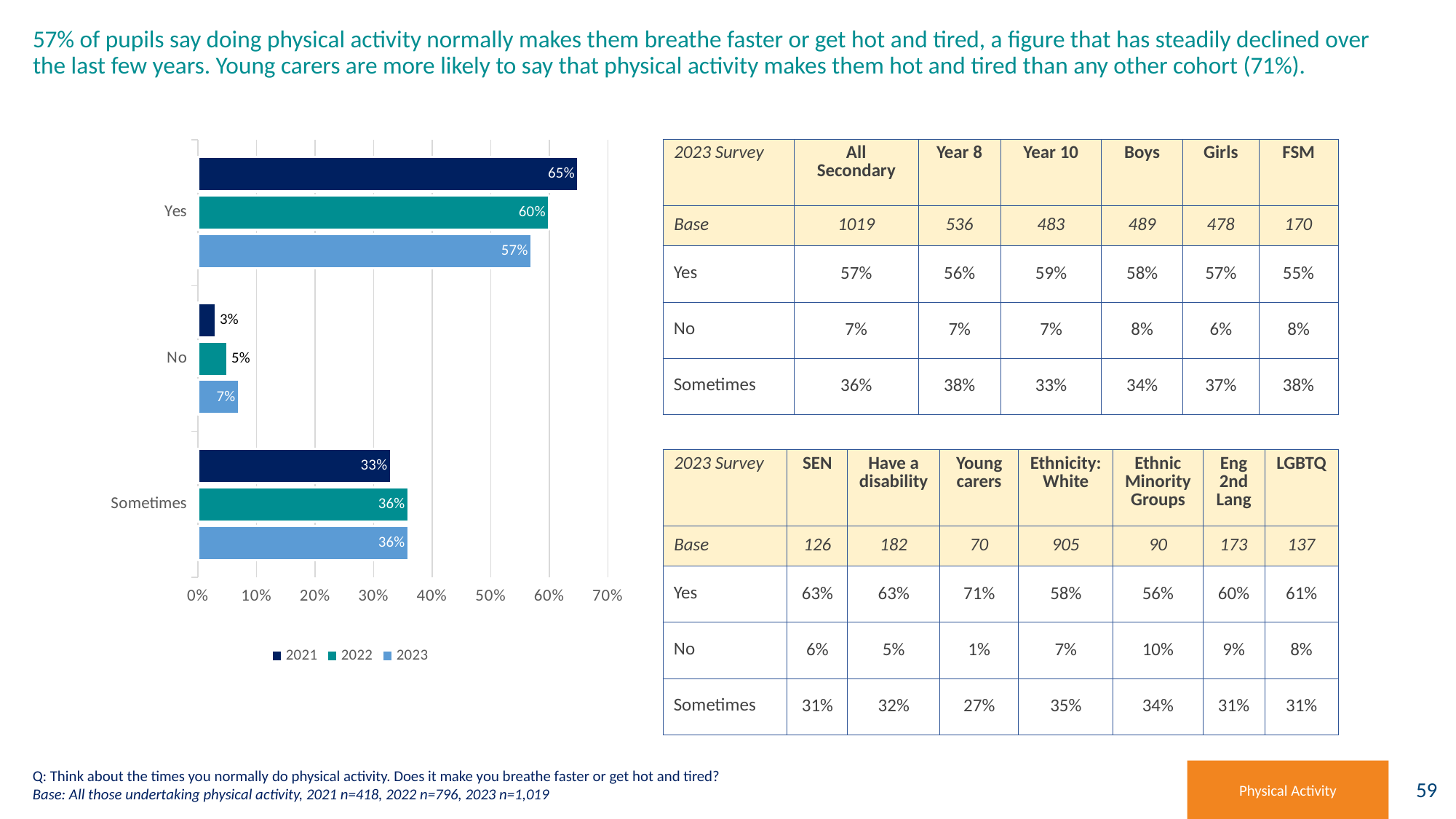
What percentage of pupils answered 'Yes' in 2023? 57% What percentage of pupils answered 'Sometimes' in 2022? 36% How many response categories are shown on the chart? 3 What is the difference between the 'Yes' percentage in 2021 and in 2023? 8 percentage points What percentage of pupils answered 'No' in 2021? 3% How many series does the chart legend list? 3 Which is larger: the 'Sometimes' value for 2021 or for 2023? 2023 Is the 'Yes' value for 2022 greater or less than 50%? greater Which year had the lowest percentage of pupils answering 'No'? 2021 Does the 'No' percentage rise or fall from 2021 to 2023? Rise What type of chart is shown on the slide? Bar chart Which year had the highest percentage of pupils answering 'Yes'? 2021